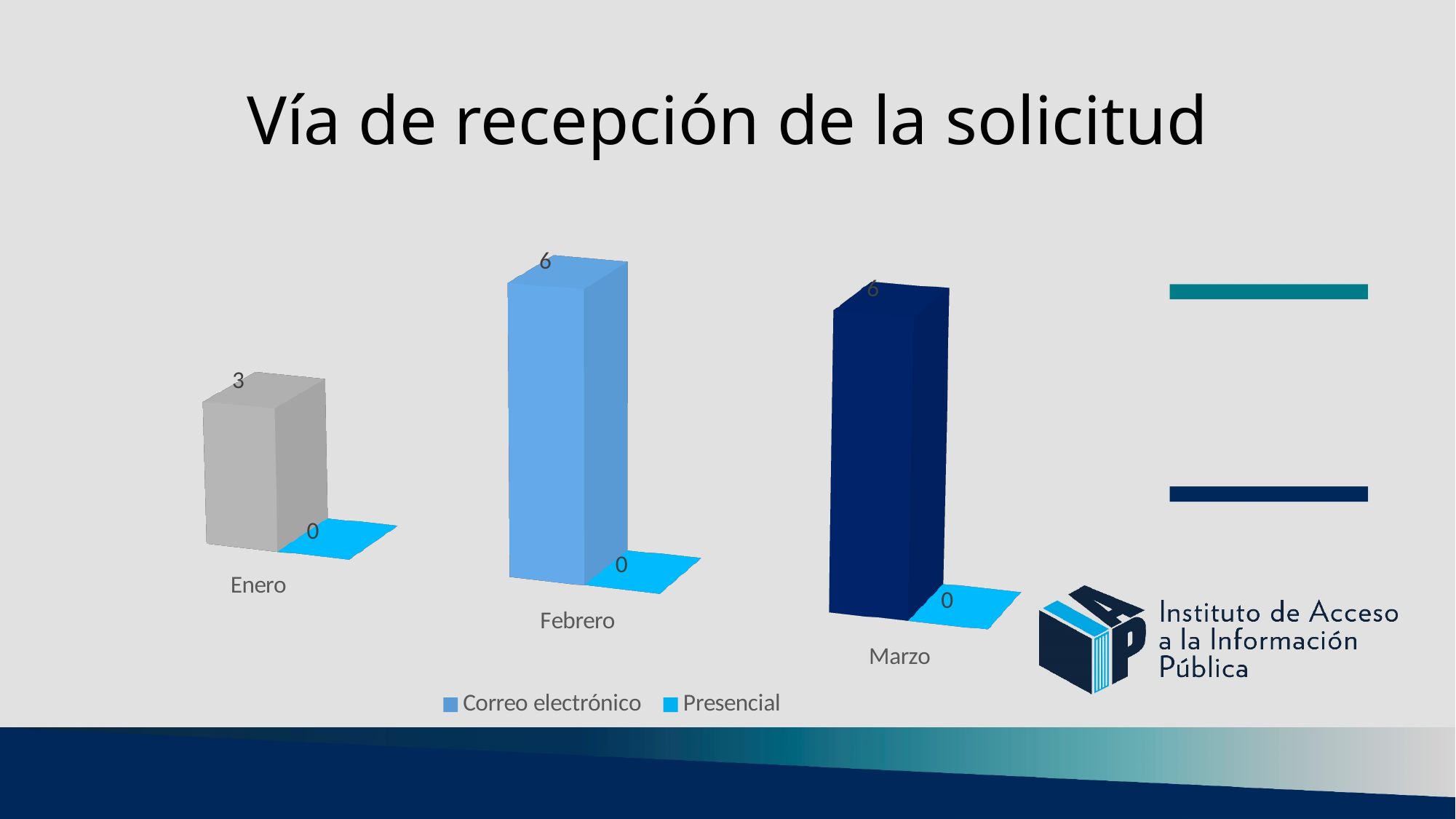
What is the value for Correo electrónico in Marzo? 6 Which is larger, the Correo electrónico value for Enero or for Marzo? Marzo Does the Correo electrónico value rise or fall from Enero to Febrero? Rise What is the value for Presencial in Febrero? 0 What is the title of the chart? Vía de recepción de la solicitud Which month has the lowest value for Correo electrónico? Enero What is the value for Correo electrónico in Enero? 3 What is the value for Correo electrónico in Febrero? 6 What kind of chart is shown on the slide? Bar chart What is the difference between the Correo electrónico values for Febrero and Enero? 3 How many months are shown on the x axis? 3 How many series does the legend list? 2